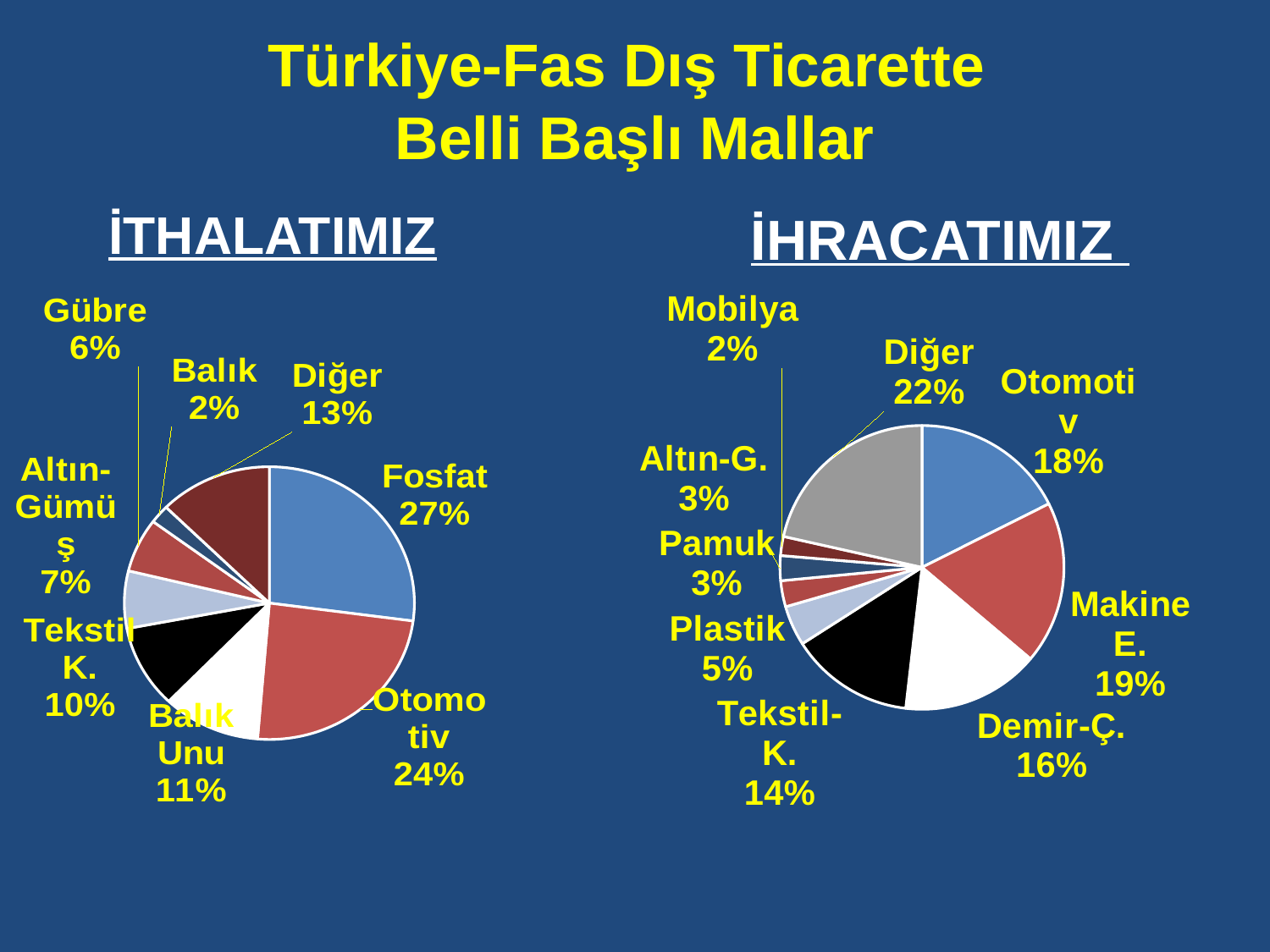
In the İTHALATIMIZ pie chart, how many slices are there? 8 In the İHRACATIMIZ pie chart, what share does Demir-Ç. have? 16% In the İTHALATIMIZ pie chart, how many percentage points larger is Fosfat than Otomotiv? 3 In the İTHALATIMIZ pie chart, which category has the smallest share? Balık What type of chart is used for İTHALATIMIZ and İHRACATIMIZ? Pie chart In the İTHALATIMIZ pie chart, what share does Fosfat have? 27% In the İTHALATIMIZ pie chart, what share does Balık Unu have? 11% In the İHRACATIMIZ pie chart, how many slices are there? 9 In the İHRACATIMIZ pie chart, which category has the smallest share? Mobilya In the İHRACATIMIZ pie chart, what share does Makine E. have? 19% In the İTHALATIMIZ pie chart, which named category (excluding Diğer) has the largest share? Fosfat In the İHRACATIMIZ pie chart, which is larger, Otomotiv or Tekstil-K.? Otomotiv